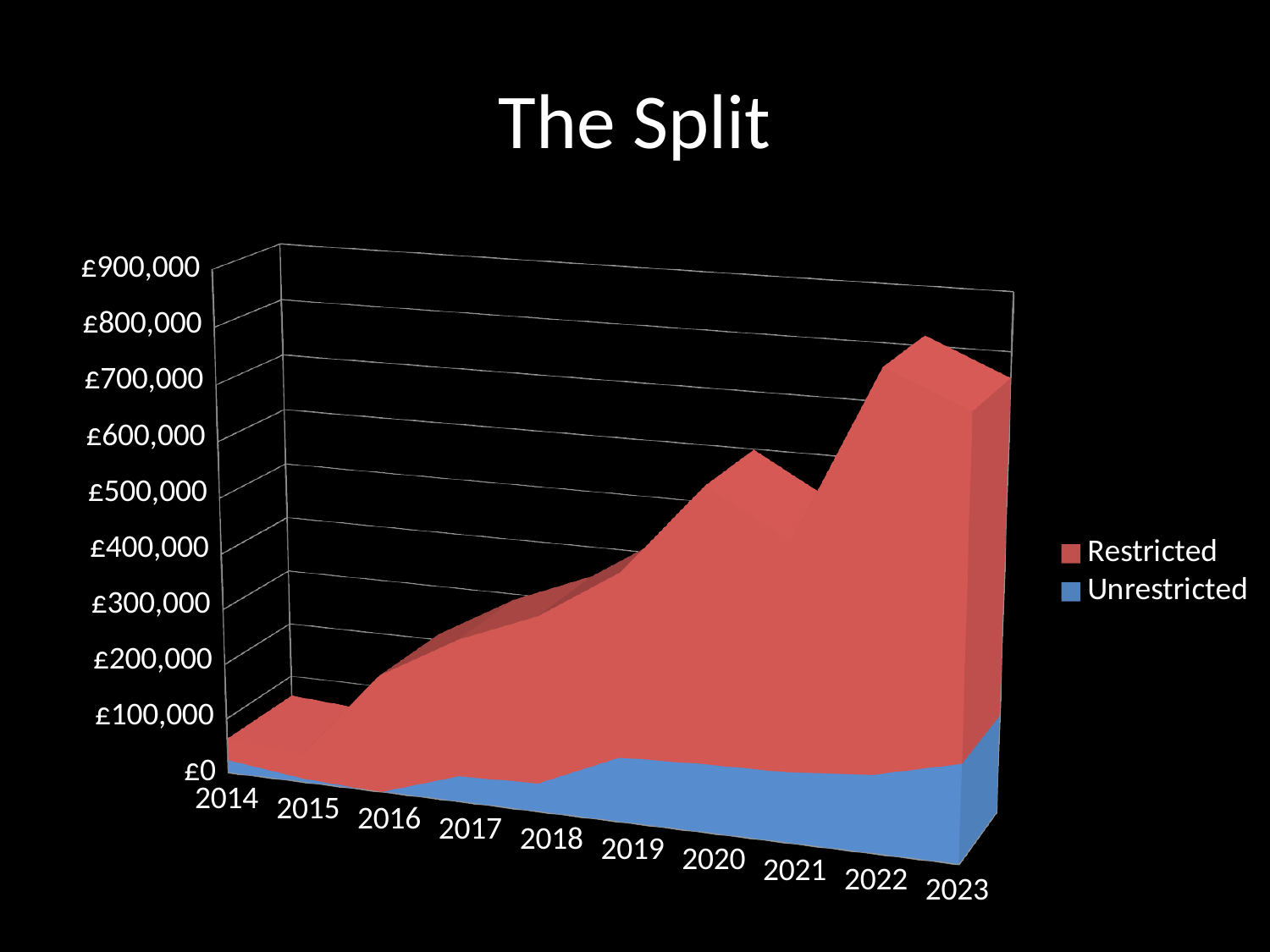
How many years are shown along the x axis? 10 Which series is shown in red? Restricted Is the total value for 2014 greater or less than £200,000? less Is the total value for 2022 greater or less than £500,000? greater Do the total values generally rise or fall from 2014 to 2022? Rise How many series does the legend list? 2 What kind of chart is shown on the slide? Area chart In 2023, which series is larger, Restricted or Unrestricted? Restricted Which year has the lowest total value? 2015 Is the Unrestricted value for 2019 greater or less than £300,000? less What is the title of the chart? The Split Which year has the highest total value? 2022